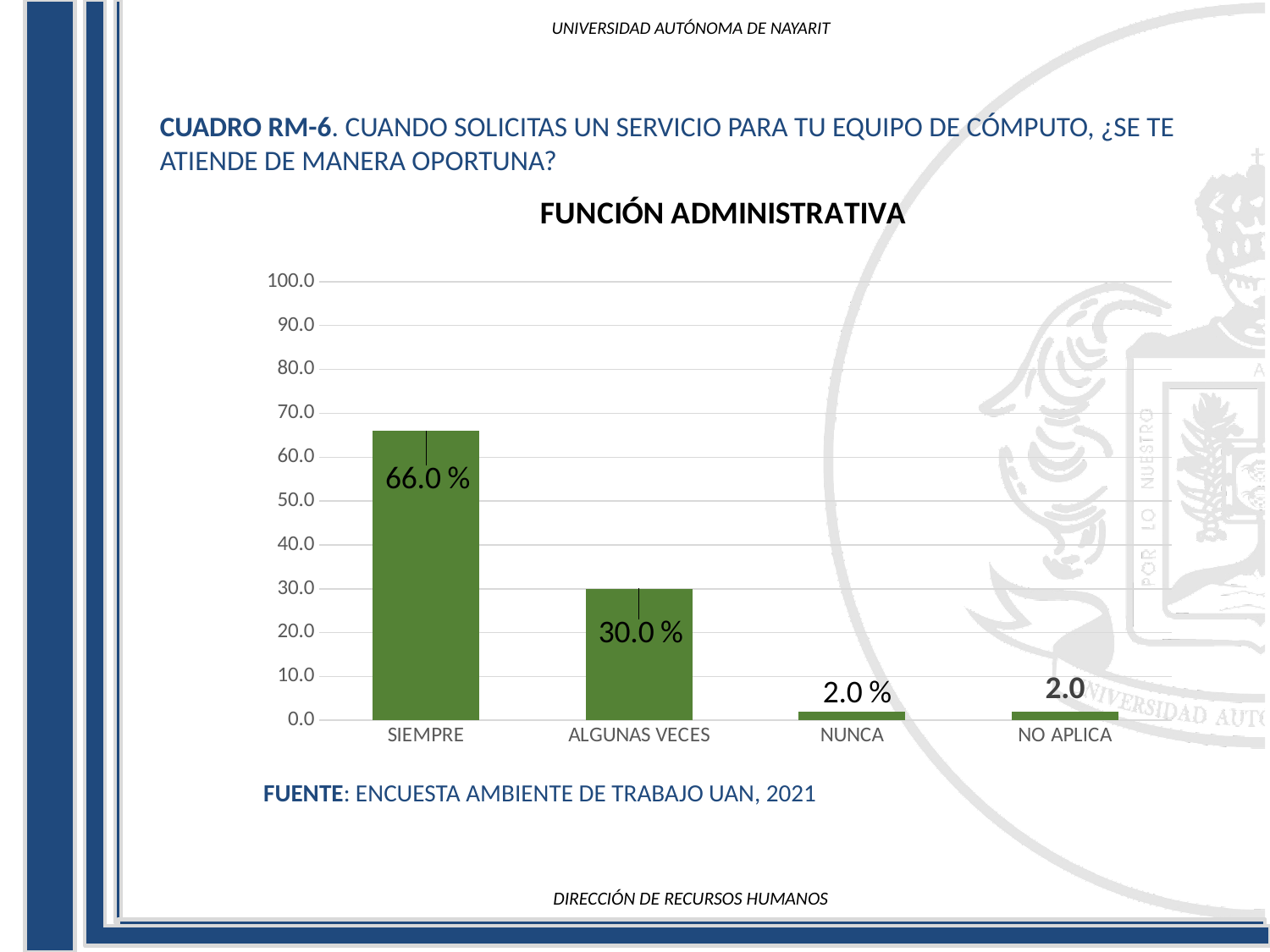
What is the difference between the values for SIEMPRE and ALGUNAS VECES? 36.0 % Is the value for SIEMPRE greater or less than 60.0? greater What is the title of the chart? FUNCIÓN ADMINISTRATIVA What is the value for ALGUNAS VECES? 30.0 % What kind of chart is shown on the slide? bar chart Which category has the highest value? SIEMPRE How many categories are shown on the x axis? 4 Is the value for ALGUNAS VECES greater or less than 40.0? less What is the value for SIEMPRE? 66.0 % What is the value for NUNCA? 2.0 % Which is larger, the value for ALGUNAS VECES or the value for NUNCA? ALGUNAS VECES Do the values rise or fall from SIEMPRE to NUNCA along the x axis? fall